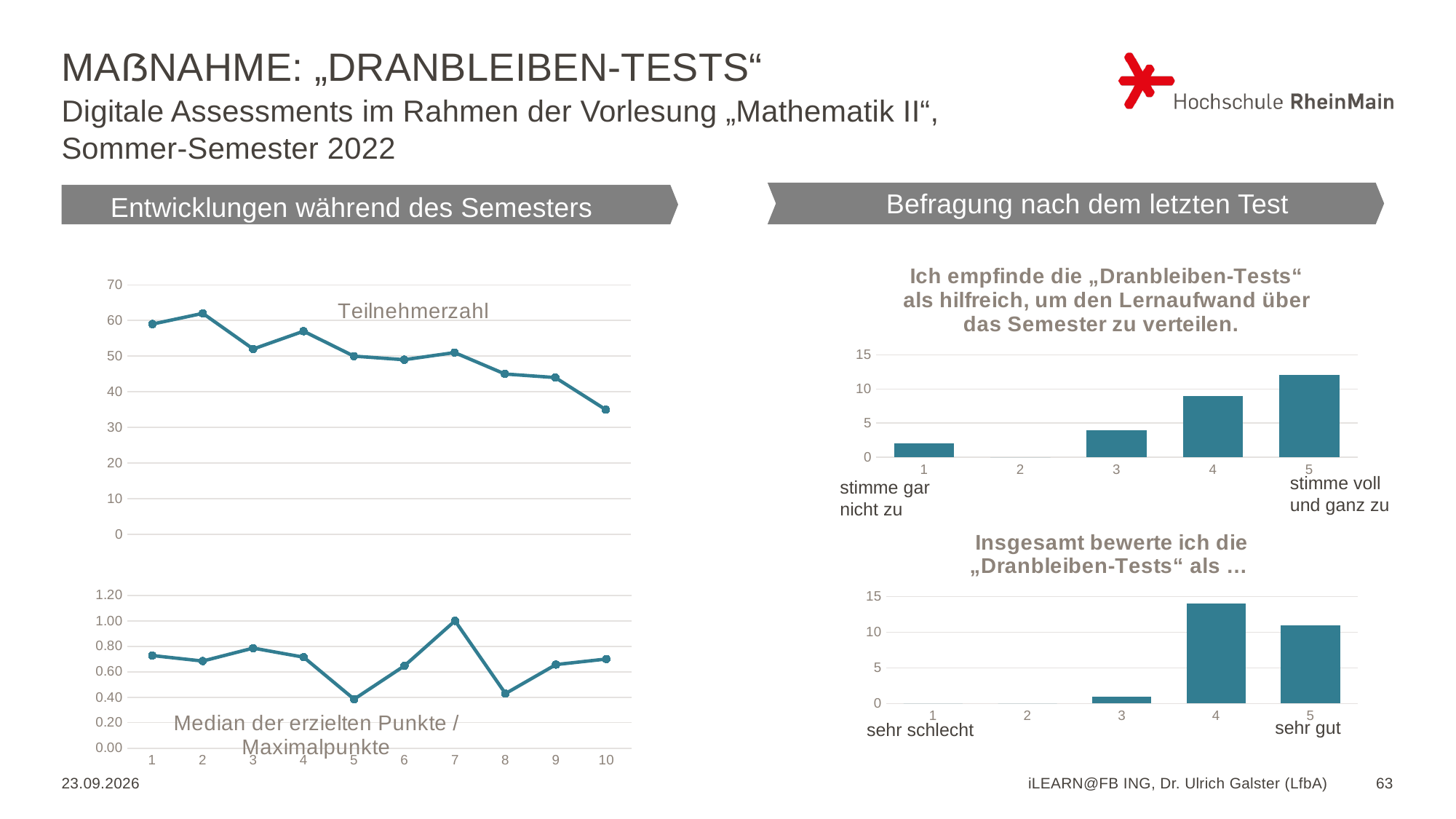
On the 'Median der erzielten Punkte / Maximalpunkte' chart (bottom left), is the value for test 8 greater or less than 0.60? less On the Teilnehmerzahl chart (top left), do the values generally rise or fall from test 1 to test 10? fall On the 'Median der erzielten Punkte / Maximalpunkte' chart (bottom left), which test has the lowest value? 5 On the Teilnehmerzahl chart (top left), what kind of chart is it? line chart On the chart titled 'Insgesamt bewerte ich die „Dranbleiben-Tests“ als …' (bottom right), which is larger, the bar for category 4 or category 5? 4 On the Teilnehmerzahl chart (top left), which test has the highest number of participants? 2 On the chart titled 'Insgesamt bewerte ich die „Dranbleiben-Tests“ als …' (bottom right), what kind of chart is it? bar chart On the chart titled 'Ich empfinde die „Dranbleiben-Tests“ als hilfreich...' (top right), is the value for category 5 greater or less than 10? greater On the Teilnehmerzahl chart (top left), how many data points are plotted? 10 On the 'Median der erzielten Punkte / Maximalpunkte' chart (bottom left), what is the value for test 7? 1.00 On the Teilnehmerzahl chart (top left), is the value for test 10 greater or less than 40? less On the chart titled 'Ich empfinde die „Dranbleiben-Tests“ als hilfreich...' (top right), which rating category has the highest bar? 5